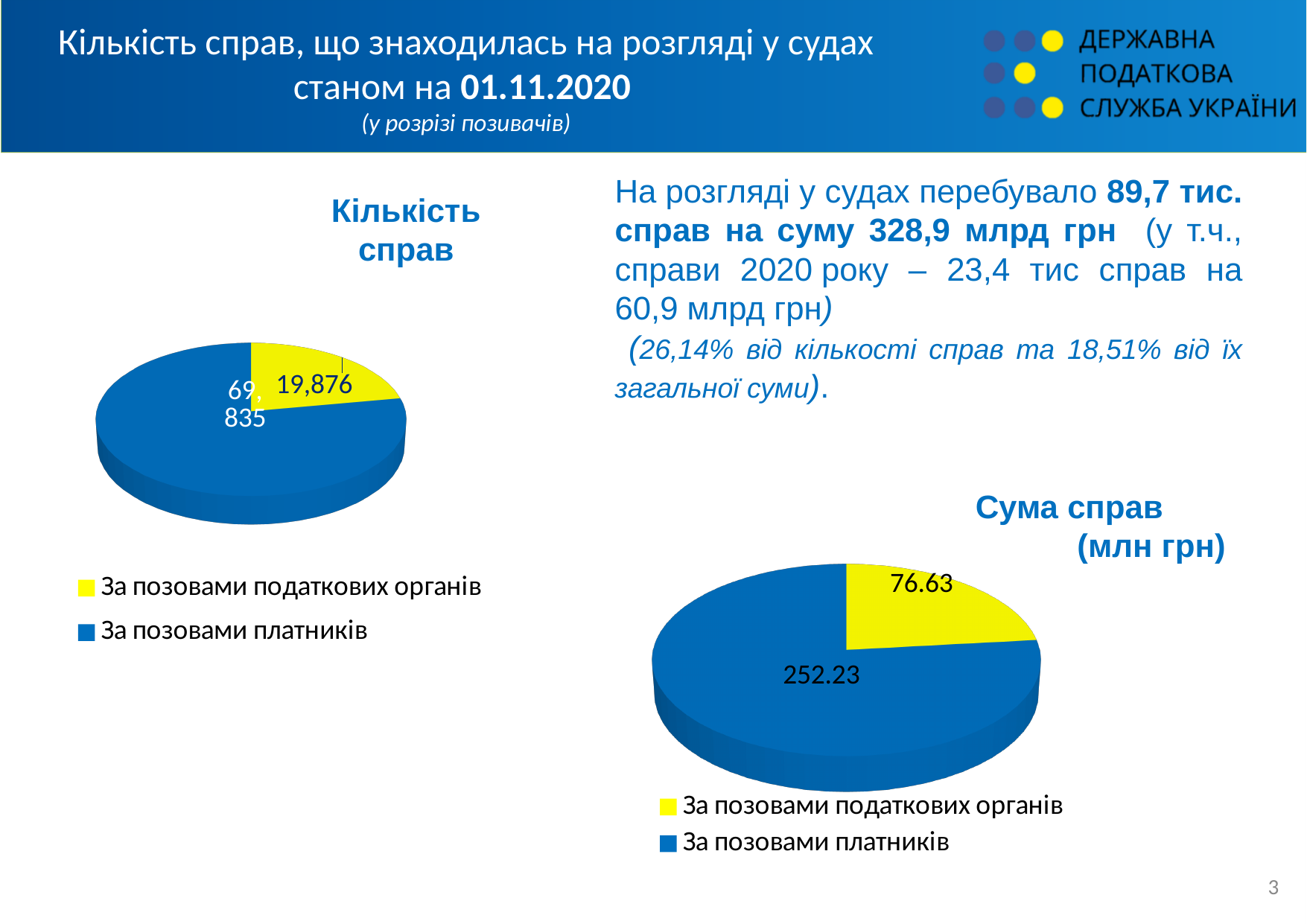
What type of chart is the 'Кількість справ' chart? Pie chart How many slices does the 'Сума справ (млн грн)' chart have? 2 In the 'Кількість справ' chart, what is the value for 'За позовами податкових органів'? 19,876 In the 'Сума справ (млн грн)' chart, what is the value for 'За позовами податкових органів'? 76.63 In the 'Кількість справ' chart, what is the difference between the values for 'За позовами платників' and 'За позовами податкових органів'? 49,959 In the 'Сума справ (млн грн)' chart, which is larger: 'За позовами податкових органів' or 'За позовами платників'? За позовами платників In the 'Сума справ (млн грн)' chart, which category has the smallest slice? За позовами податкових органів In the 'Сума справ (млн грн)' chart, what is the difference between the values for 'За позовами платників' and 'За позовами податкових органів'? 175.6 In the 'Кількість справ' chart, what colour is the slice for 'За позовами податкових органів'? Yellow In the 'Кількість справ' chart, which category has the largest slice? За позовами платників In the 'Сума справ (млн грн)' chart, what is the value for 'За позовами платників'? 252.23 In the 'Кількість справ' chart, what is the value for 'За позовами платників'? 69,835